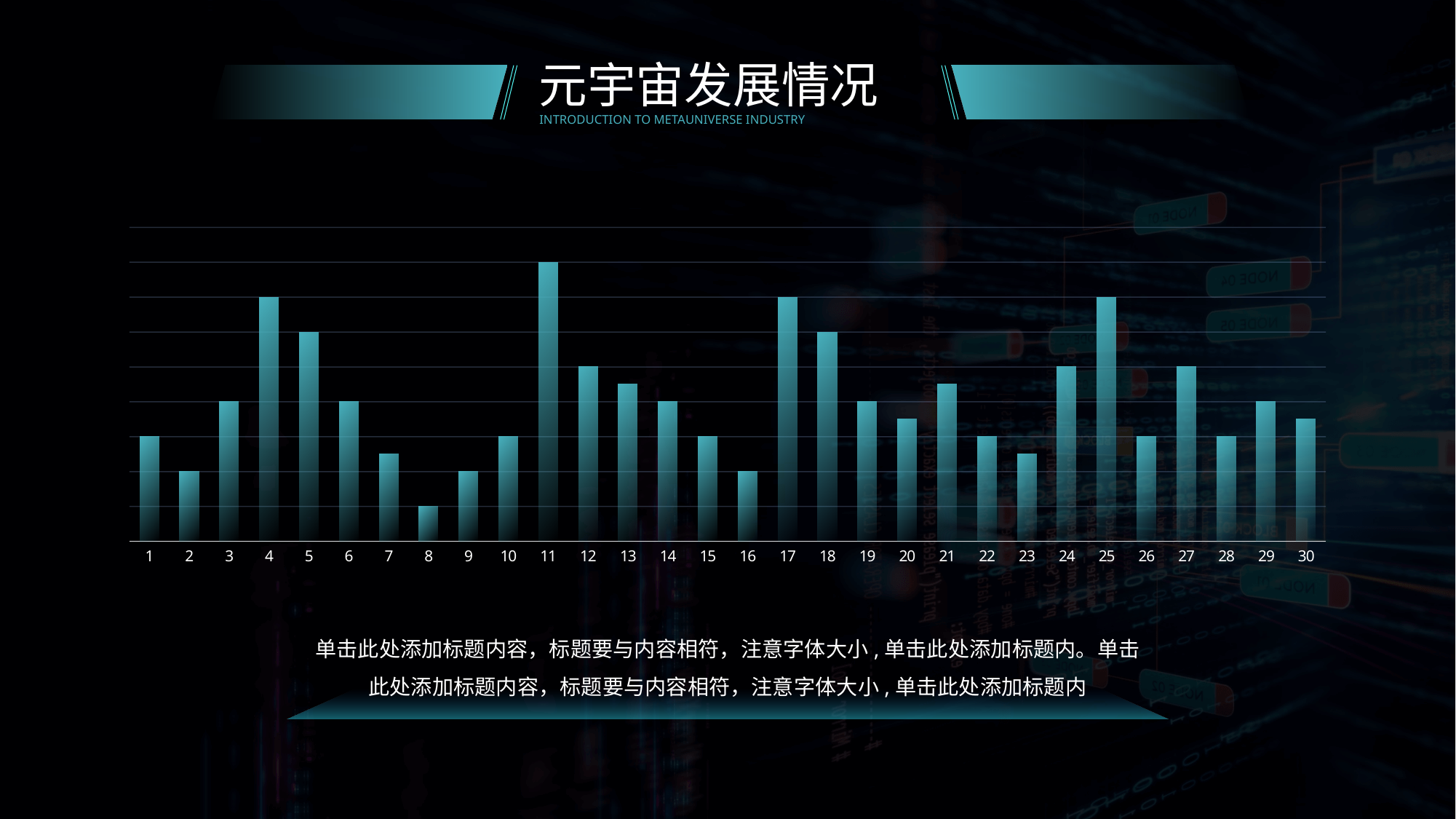
Which category has the lowest bar in the chart? 8 What is the title shown above the chart on the slide? 元宇宙发展情况 Which has the larger value, category 4 or category 7? 4 Which has the larger value, category 12 or category 15? 12 Which category has the highest bar in the chart? 11 Which has the larger value, category 23 or category 25? 25 What kind of chart is shown on the slide? bar chart What is the first category label on the x axis of the chart? 1 How many categories are plotted along the x axis of the chart? 30